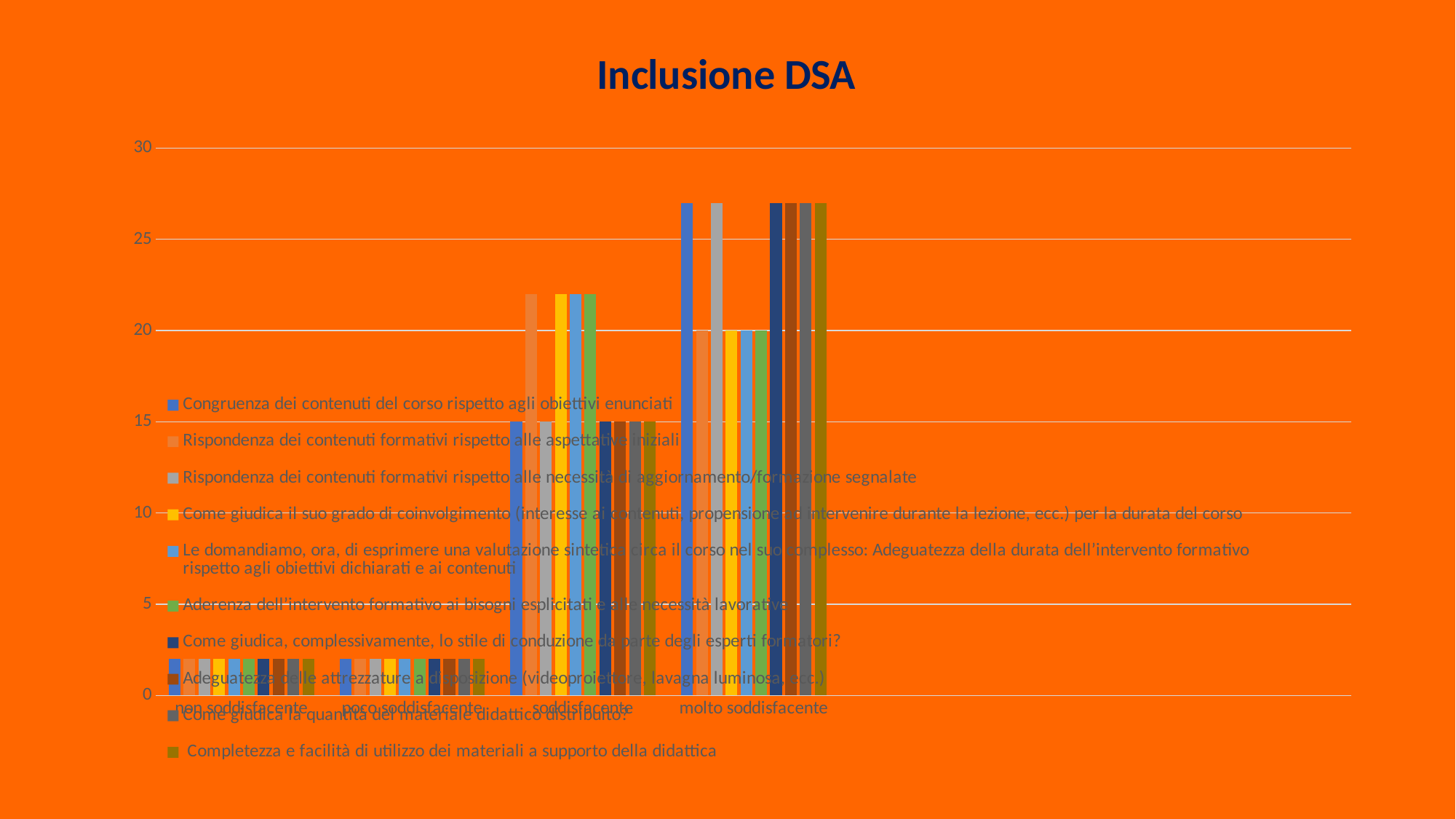
Do the values for 'Congruenza dei contenuti del corso rispetto agli obiettivi enunciati' rise or fall from 'non soddisfacente' to 'molto soddisfacente'? rise How many series does the chart's legend list? 10 Is the value for 'Congruenza dei contenuti del corso rispetto agli obiettivi enunciati' in the 'molto soddisfacente' category greater or less than 25? greater How many categories are shown on the x axis of the chart? 4 Is the value for 'Rispondenza dei contenuti formativi rispetto alle aspettative iniziali' in the 'soddisfacente' category greater or less than 20? greater What is the title of the chart? Inclusione DSA For the series 'Congruenza dei contenuti del corso rispetto agli obiettivi enunciati', which category has the highest value? molto soddisfacente What is the value for 'Congruenza dei contenuti del corso rispetto agli obiettivi enunciati' in the 'soddisfacente' category? 15 Is the value for 'Congruenza dei contenuti del corso rispetto agli obiettivi enunciati' in the 'non soddisfacente' category greater or less than 5? less For 'Come giudica, complessivamente, lo stile di conduzione da parte degli esperti formatori?', which is larger: the value for 'soddisfacente' or for 'molto soddisfacente'? molto soddisfacente What kind of chart is shown on the slide? bar chart What is the value for 'Rispondenza dei contenuti formativi rispetto alle aspettative iniziali' in the 'molto soddisfacente' category? 20